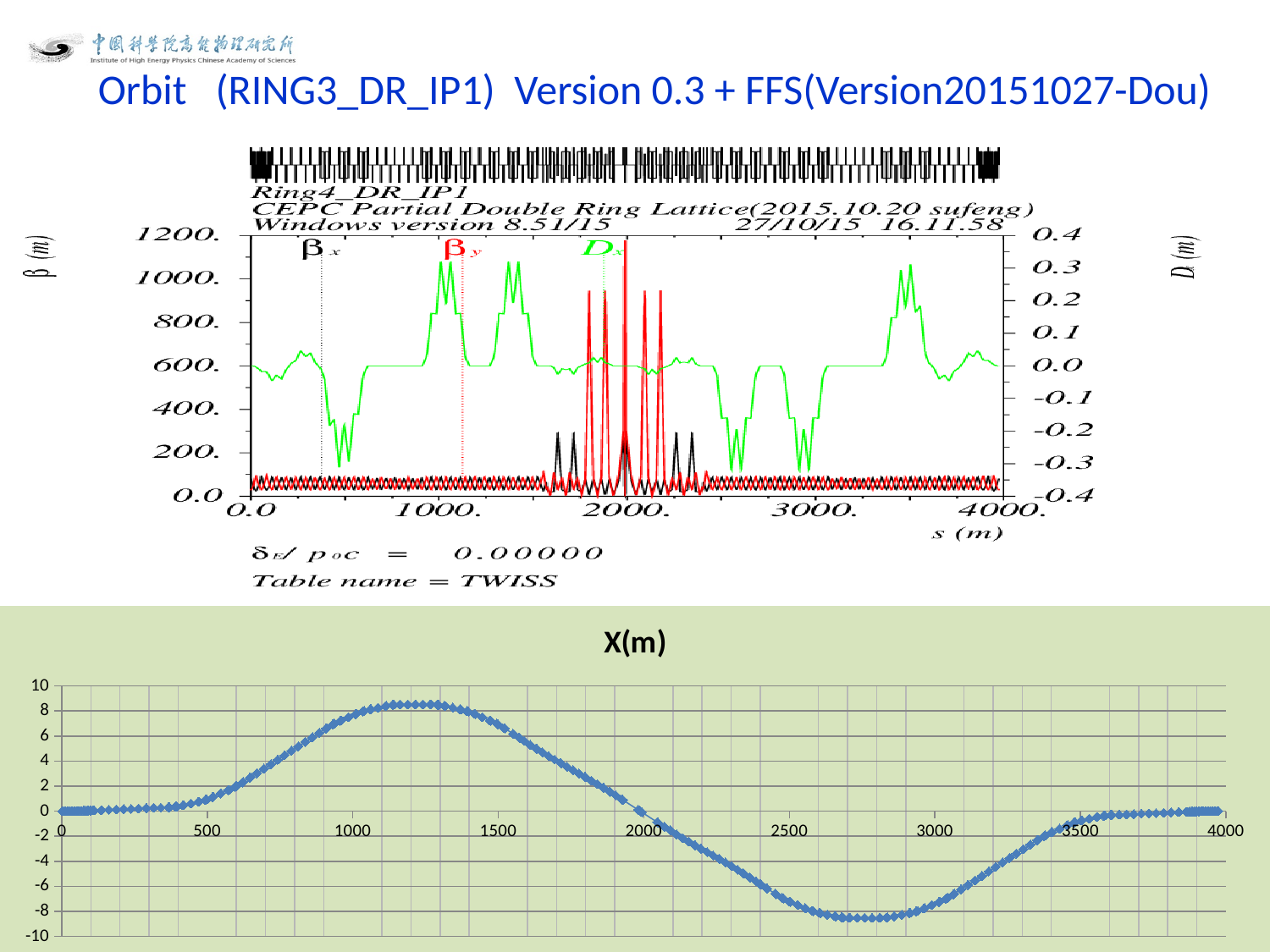
In the bottom chart X(m), do the values rise or fall as x goes from 1500 to 2500? fall What is the title of the bottom chart? X(m) In the bottom chart X(m), is the value at x = 0 greater or less than 2? less In the top chart (Ring4_DR_IP1 lattice plot), what is the highest tick value shown on the left β (m) axis? 1200. In the bottom chart X(m), is the value at x = 1250 greater or less than 6? greater In the bottom chart X(m), do the values rise or fall as x goes from 500 to 1200? rise In the top chart (Ring4_DR_IP1 lattice plot), which series is drawn in green? Dx What kind of chart is the bottom chart titled X(m)? scatter chart In the bottom chart X(m), which is larger: the value at x = 1000 or the value at x = 3000? the value at x = 1000 In the bottom chart X(m), is the value at x = 2750 greater or less than -6? less How many series does the legend of the top chart (Ring4_DR_IP1 lattice plot) list? 3